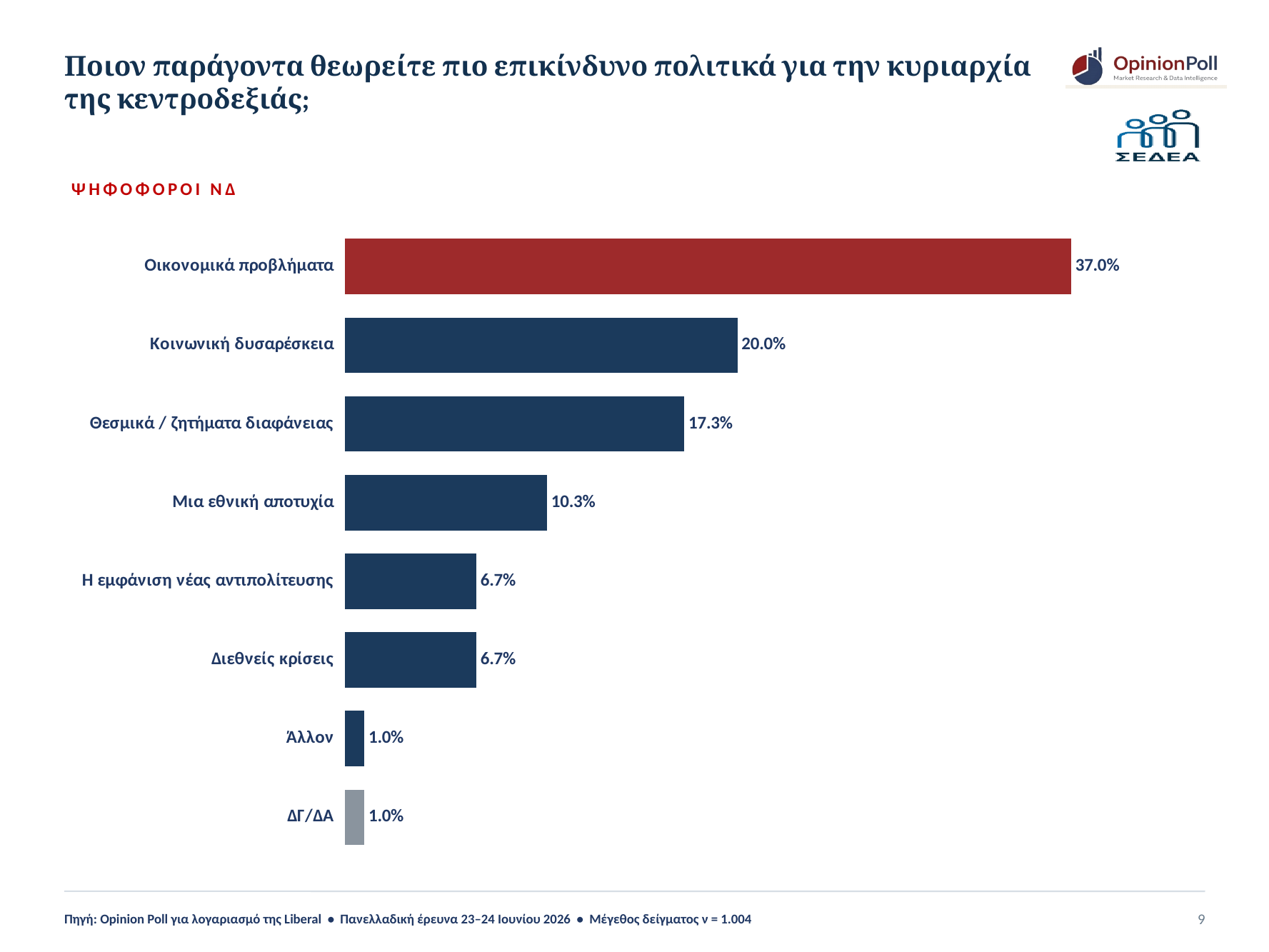
What is the difference between Κοινωνική δυσαρέσκεια and Θεσμικά / ζητήματα διαφάνειας? 2.7% What is the value for Θεσμικά / ζητήματα διαφάνειας? 17.3% What kind of chart is shown on the slide? Bar chart What is the value for Η εμφάνιση νέας αντιπολίτευσης? 6.7% What is the value for ΔΓ/ΔΑ? 1.0% How many categories are shown in the chart? 8 What is the difference between Οικονομικά προβλήματα and Κοινωνική δυσαρέσκεια? 17.0% What is the value for Οικονομικά προβλήματα? 37.0% Which category's bar is coloured red? Οικονομικά προβλήματα What is the value for Μια εθνική αποτυχία? 10.3% Which category has the highest value? Οικονομικά προβλήματα Which is larger, Μια εθνική αποτυχία or Διεθνείς κρίσεις? Μια εθνική αποτυχία